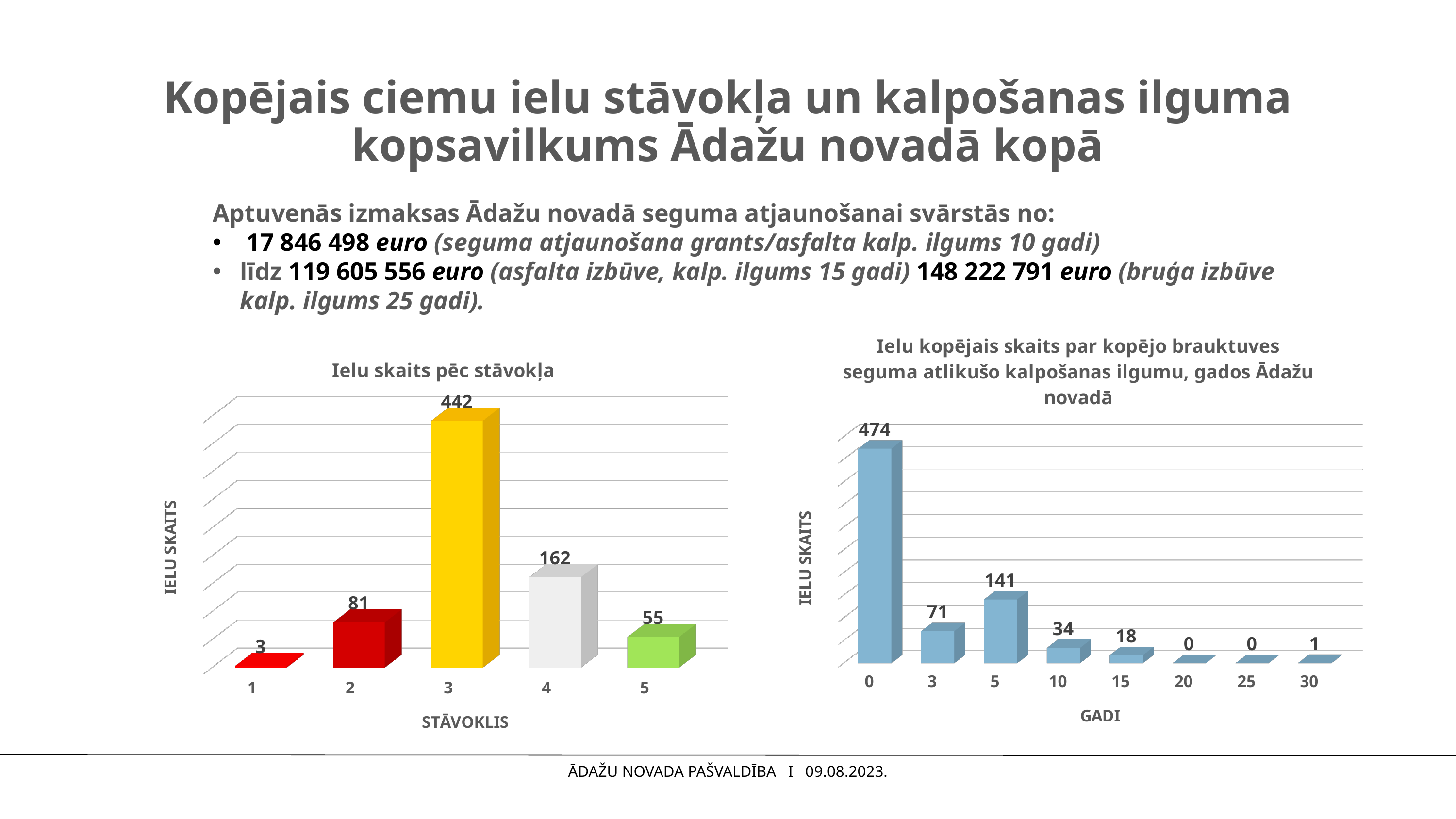
In the chart 'Ielu skaits pēc stāvokļa', what is the value for stāvoklis 3? 442 In the chart 'Ielu kopējais skaits par kopējo brauktuves seguma atlikušo kalpošanas ilgumu, gados Ādažu novadā', which is larger, the value for 3 gadi or the value for 5 gadi? 5 gadi In the chart 'Ielu skaits pēc stāvokļa', how many stāvoklis categories are shown on the x axis? 5 In the chart 'Ielu skaits pēc stāvokļa', what colour is the bar for stāvoklis 3? Yellow In the chart 'Ielu kopējais skaits par kopējo brauktuves seguma atlikušo kalpošanas ilgumu, gados Ādažu novadā', how many gadi categories are shown on the x axis? 8 In the chart 'Ielu skaits pēc stāvokļa', which stāvoklis category has the lowest value? 1 In the chart 'Ielu kopējais skaits par kopējo brauktuves seguma atlikušo kalpošanas ilgumu, gados Ādažu novadā', what is the value for 0 gadi? 474 In the chart 'Ielu kopējais skaits par kopējo brauktuves seguma atlikušo kalpošanas ilgumu, gados Ādažu novadā', which gadi category has the highest value? 0 What type of chart is the chart on the right of the slide? Bar chart In the chart 'Ielu kopējais skaits par kopējo brauktuves seguma atlikušo kalpošanas ilgumu, gados Ādažu novadā', what is the difference between the values for 0 gadi and 5 gadi? 333 In the chart 'Ielu kopējais skaits par kopējo brauktuves seguma atlikušo kalpošanas ilgumu, gados Ādažu novadā', what is the value for 10 gadi? 34 In the chart 'Ielu skaits pēc stāvokļa', what is the difference between the values for stāvoklis 4 and stāvoklis 5? 107